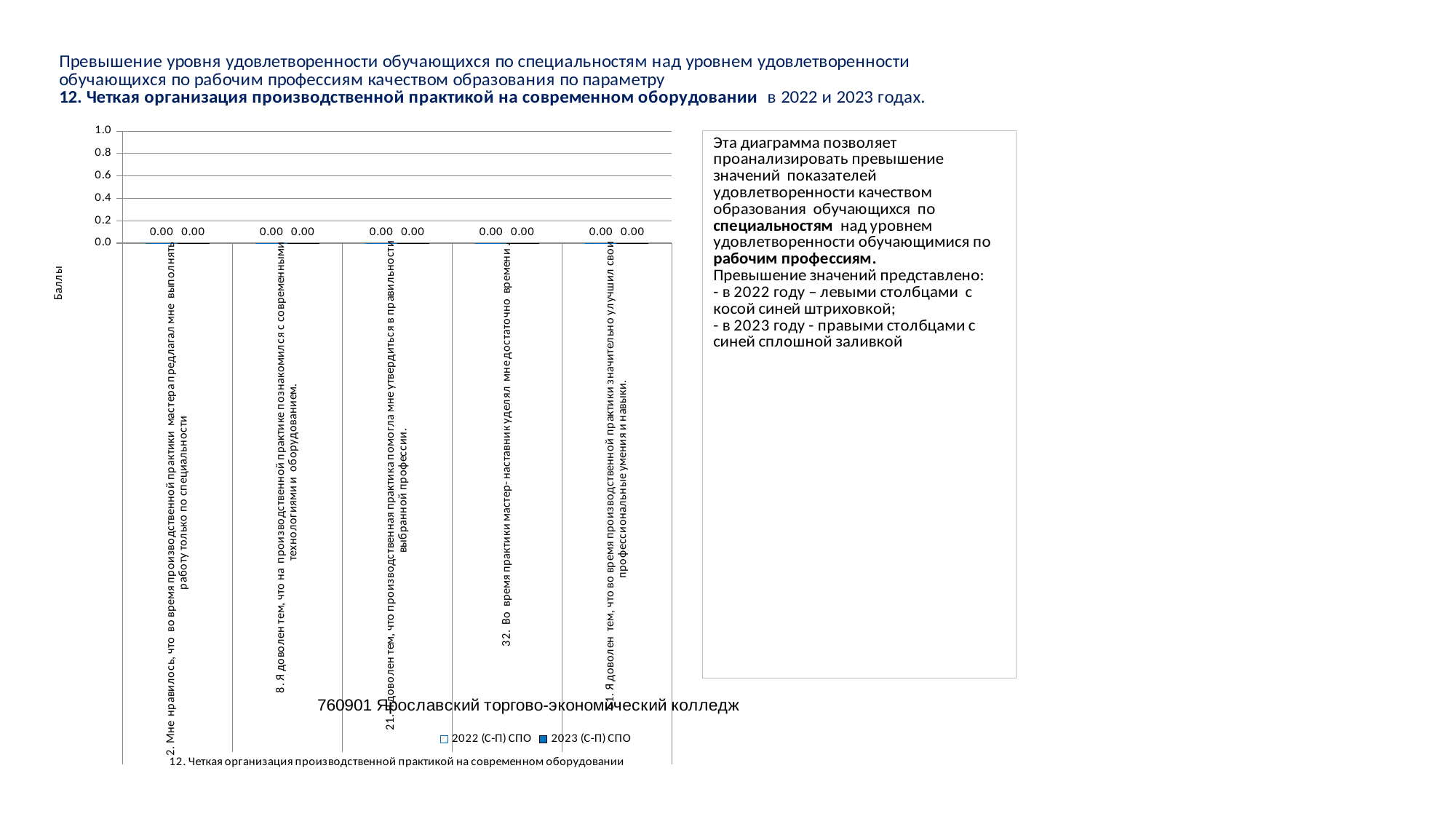
What is the value of the 2022 (С-П) СПО series for category 8 ("Я доволен тем, что на производственной практике познакомился с современными технологиями и оборудованием")? 0.00 Is the 2023 (С-П) СПО value for category 2 ("Мне нравилось, что во время производственной практики мастер предлагал мне выполнять работу только по специальности") greater or less than 0.2? less What is the value of the 2023 (С-П) СПО series for category 32 ("Во время практики мастер-наставник уделял мне достаточно времени")? 0.00 How many categories are plotted along the x axis of the chart? 5 What are the two legend entries of the chart? 2022 (С-П) СПО and 2023 (С-П) СПО What is the difference between the 2022 (С-П) СПО and 2023 (С-П) СПО values for category 21 ("Я доволен тем, что производственная практика помогла мне утвердиться в правильности выбранной профессии")? 0.00 Do the values of the 2022 (С-П) СПО series rise, fall, or stay flat across the categories on the x axis? stay flat What is the label of the chart's vertical axis? Баллы What kind of chart is shown on the slide? bar chart What is the highest tick value shown on the chart's vertical axis? 1.0 How many series does the chart legend list? 2